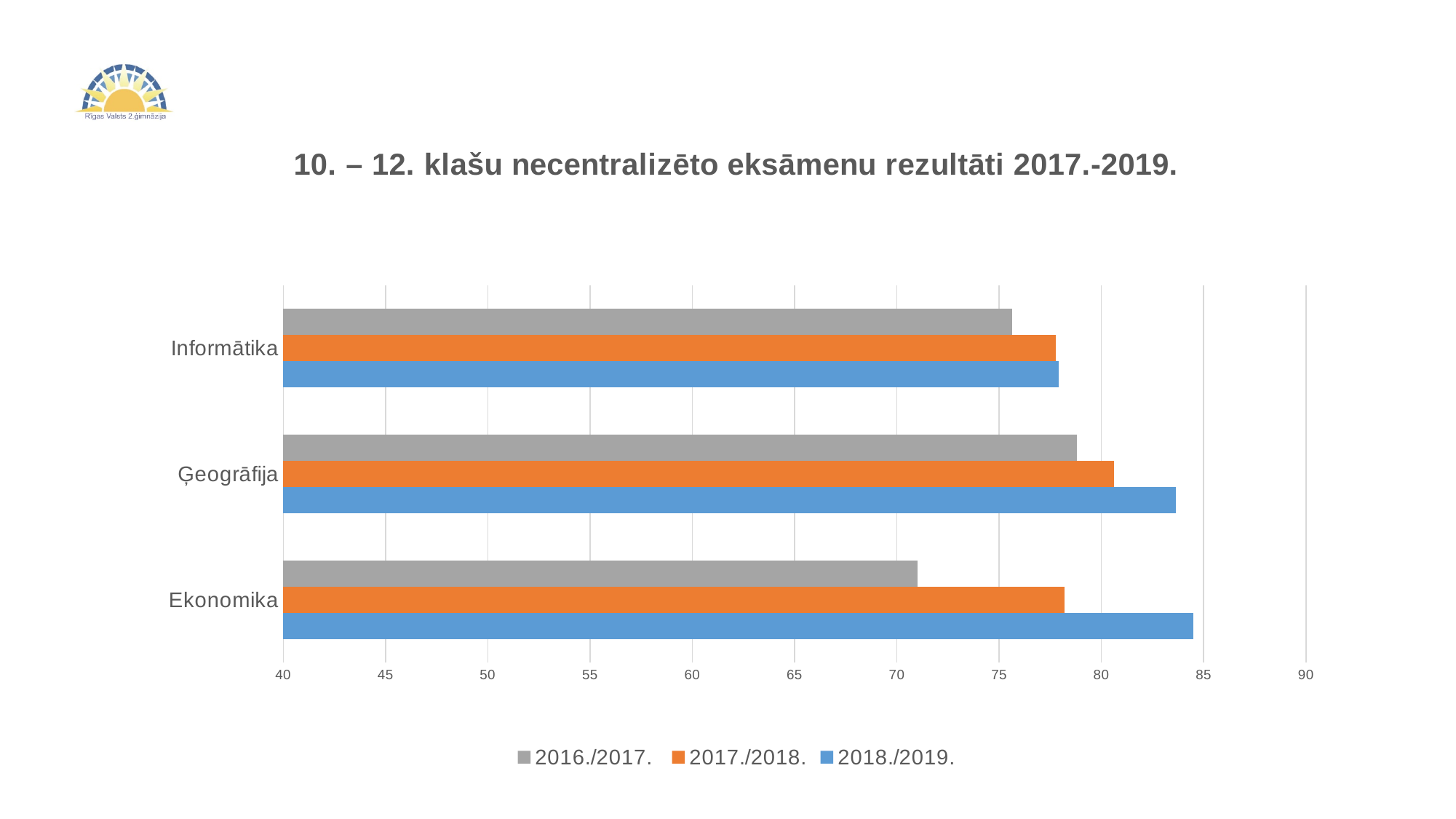
Which subject has the lowest value for the 2016./2017. series? Ekonomika How many series does the legend list? 3 Is the 2016./2017. value for Ekonomika greater or less than 75? less Is the 2018./2019. value for Ekonomika greater or less than 80? greater What kind of chart is shown on the slide? bar chart For Ekonomika, which is larger: the 2016./2017. value or the 2018./2019. value? 2018./2019. Which subject has the highest value for the 2016./2017. series? Ģeogrāfija Which subject has the lowest value for the 2018./2019. series? Informātika Which subject has the highest value for the 2017./2018. series? Ģeogrāfija What is the title of the chart? 10. – 12. klašu necentralizēto eksāmenu rezultāti 2017.-2019. How many subjects (categories) are shown on the chart? 3 Is the 2018./2019. value for Informātika greater or less than 80? less